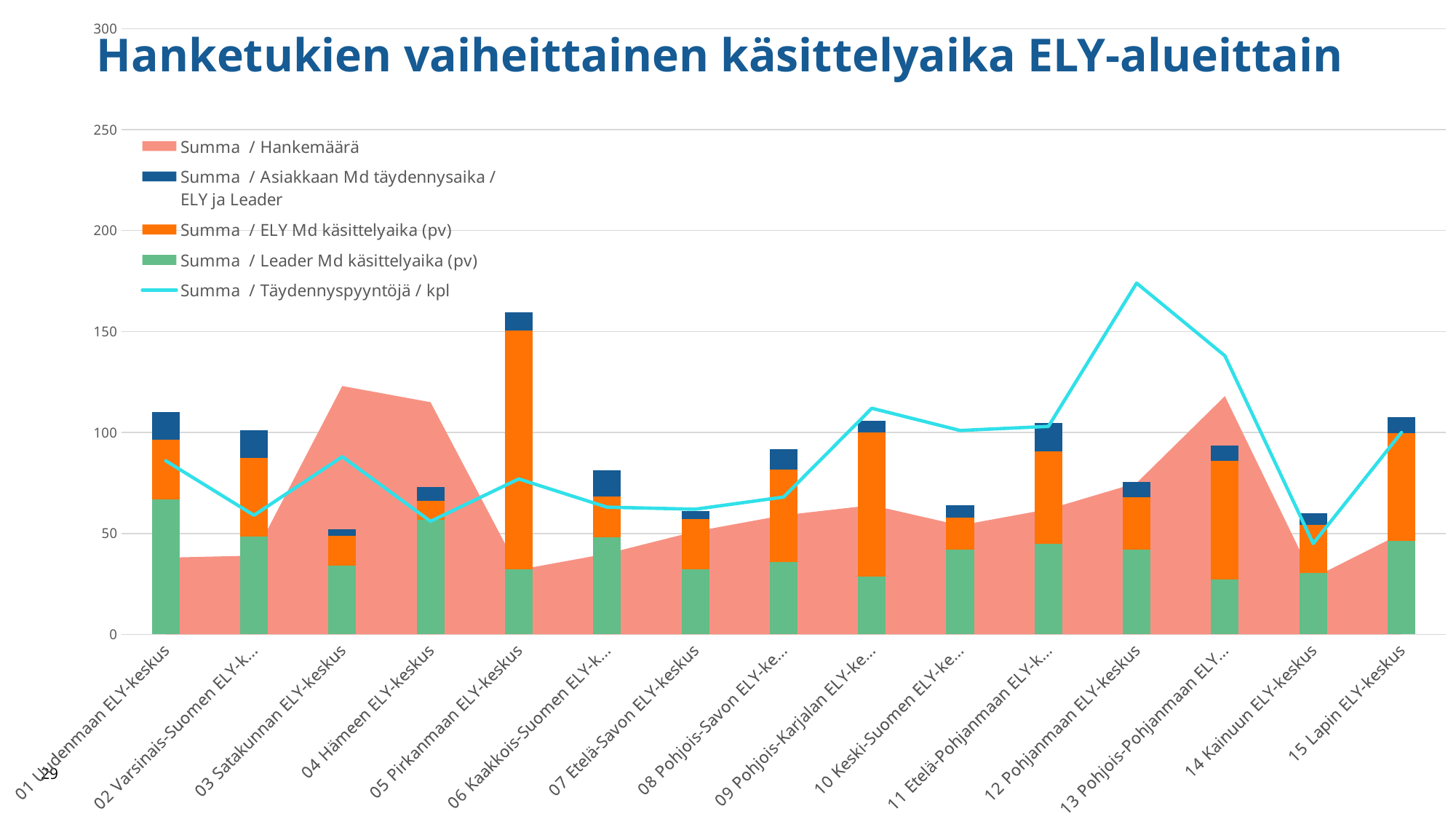
How many series does the legend list? 5 Is the Hankemäärä area value for 03 Satakunnan ELY-keskus greater or less than 100? greater Which series is drawn as the cyan line? Summa / Täydennyspyyntöjä / kpl At which category does the Täydennyspyyntöjä / kpl line reach its highest point? 12 Pohjanmaan ELY-keskus How many ELY-keskus categories are shown on the x axis? 15 What kind of chart is this? Combination chart with stacked bars, an area and a line Is the total stacked bar for 05 Pirkanmaan ELY-keskus greater or less than 150? greater What is the title of the chart? Hanketukien vaiheittainen käsittelyaika ELY-alueittain Which has the larger total stacked bar, 05 Pirkanmaan ELY-keskus or 01 Uudenmaan ELY-keskus? 05 Pirkanmaan ELY-keskus Is the Täydennyspyyntöjä / kpl value for 14 Kainuun ELY-keskus greater or less than 100? less Which category has the highest stacked bar? 05 Pirkanmaan ELY-keskus